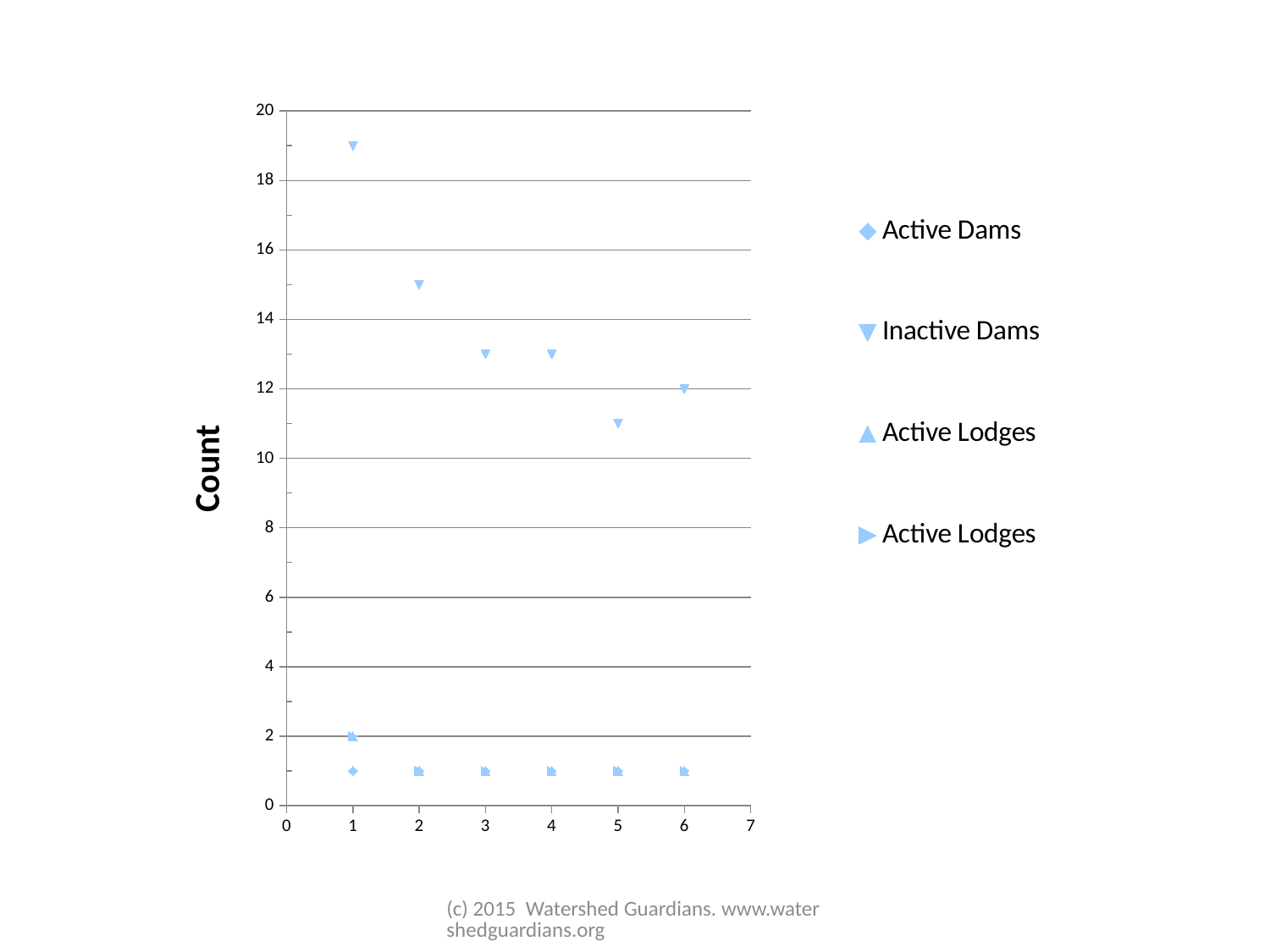
Which is larger for Inactive Dams: the value at x = 1 or at x = 2? x = 1 Is the value for Inactive Dams at x = 1 greater or less than 18? greater At which x value is Inactive Dams highest? 1 What kind of chart is shown on the slide? scatter chart At which x value is Inactive Dams lowest? 5 Is the value for Active Dams at x = 3 greater or less than 2? less What is the value of Inactive Dams at x = 6? 12 Is the value for Inactive Dams at x = 2 greater or less than 14? greater How many series does the legend list? 4 How many data points are plotted for Inactive Dams? 6 What is the title of the vertical axis? Count